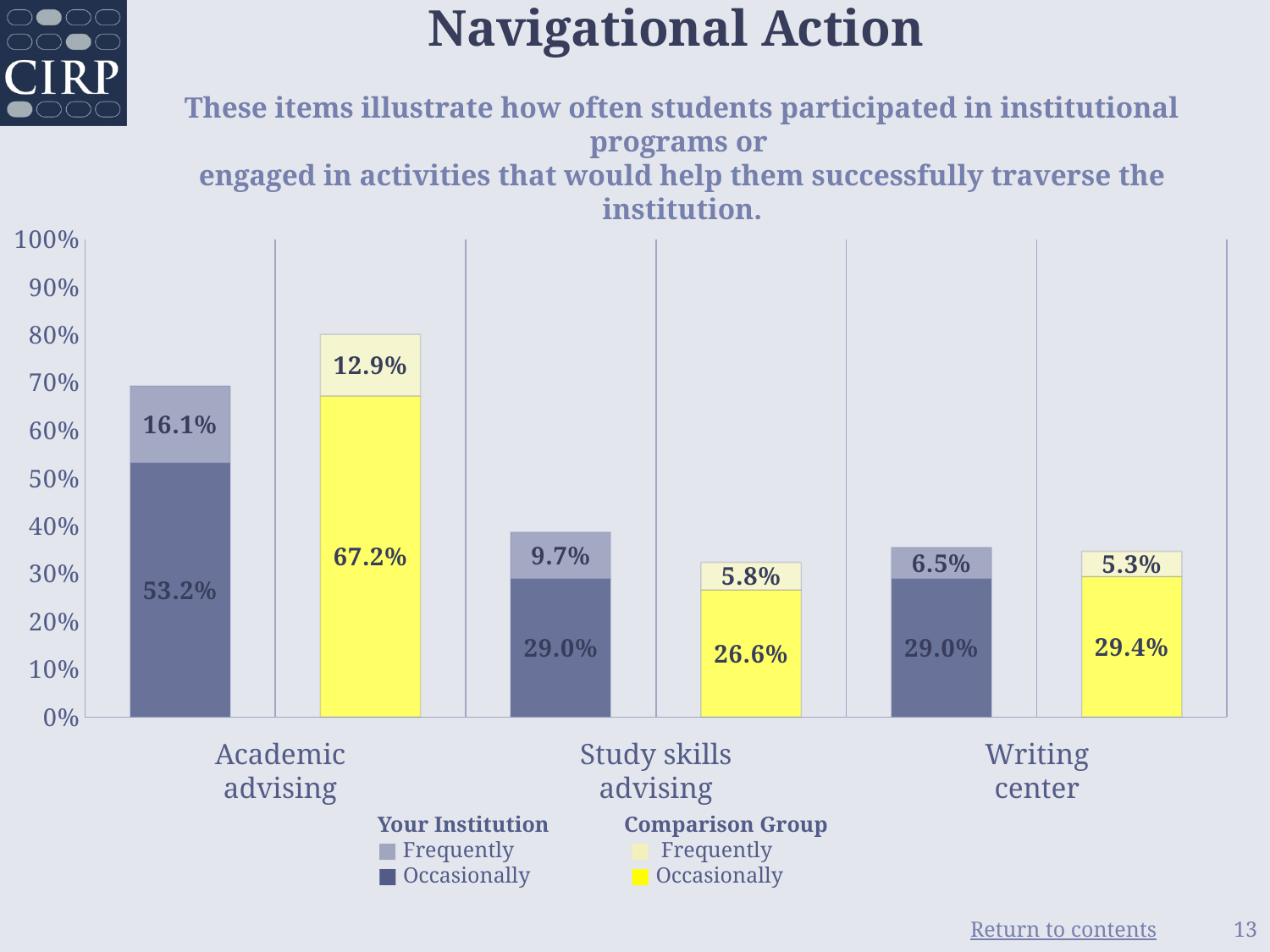
What is the total height of the Comparison Group stacked bar for academic advising? 80.1% What type of chart is shown on the slide? Stacked bar chart What is the 'Occasionally' value for the Comparison Group for the writing center? 29.4% What percentage of students at Your Institution reported occasionally using academic advising? 53.2% Which category has the highest 'Occasionally' value for the Comparison Group? Academic advising Which category has the lowest 'Frequently' value for Your Institution? Writing center How many series does the legend list? 4 What is the Comparison Group's 'Frequently' value for study skills advising? 5.8% What is the total height of the Your Institution stacked bar for academic advising? 69.3% What is the difference between the Comparison Group's and Your Institution's 'Occasionally' values for academic advising? 14.0% How many categories are shown on the x axis? 3 For study skills advising, which is larger: Your Institution's 'Frequently' value or the Comparison Group's 'Frequently' value? Your Institution